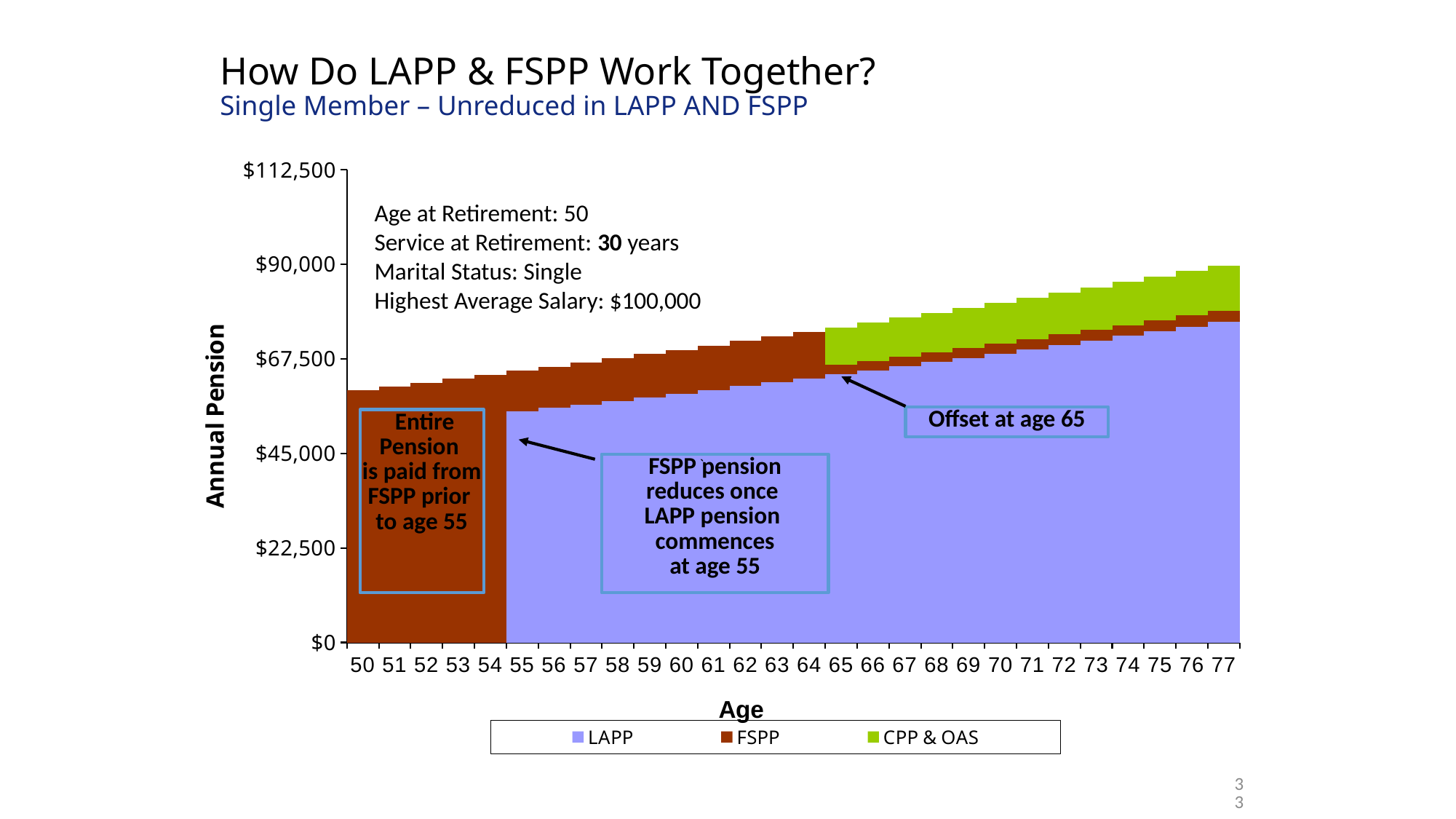
What kind of chart is shown on the slide? Stacked bar chart Which series is larger at age 60, LAPP or FSPP? LAPP Does the total annual pension rise or fall as age increases from 50 to 77? rise Which series are listed in the legend? LAPP, FSPP, CPP & OAS What is the label of the y axis? Annual Pension Is the total annual pension at age 64 greater or less than $67,500? greater Is the total annual pension at age 50 greater or less than $67,500? less Is the LAPP value at age 55 greater or less than $45,000? greater How many ages are shown along the x axis? 28 How many series does the legend list? 3